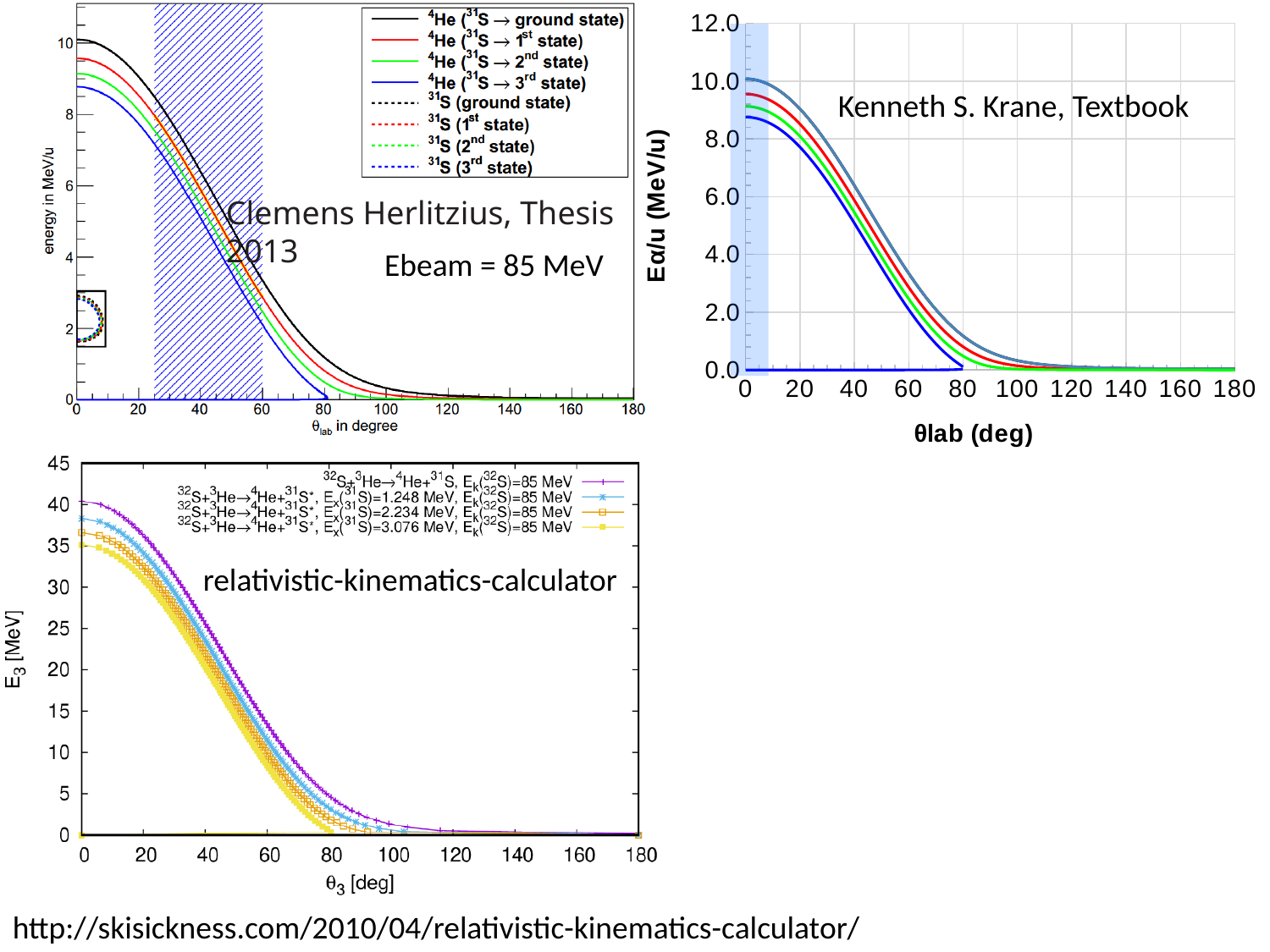
In the top-left chart (Clemens Herlitzius, Thesis 2013), do the 4He energy curves rise or fall as the lab angle increases? fall In the top-right chart (Kenneth S. Krane, Textbook), what is the label of the y axis? Eα/u (MeV/u) In the bottom-left chart (relativistic-kinematics-calculator), which series has the lowest E3 at 0 degrees? 32S+3He→4He+31S*, Ex(31S)=3.076 MeV, Ek(32S)=85 MeV In the top-left chart (Clemens Herlitzius, Thesis 2013), what beam energy is stated on the chart? Ebeam = 85 MeV In the bottom-left chart (relativistic-kinematics-calculator), is the E3 value of the Ex(31S)=3.076 MeV series at 0 degrees greater or less than 40 MeV? less In the top-left chart (Clemens Herlitzius, Thesis 2013), what kind of chart is shown? line chart In the top-left chart (Clemens Herlitzius, Thesis 2013), how many entries does the legend list? 8 In the bottom-left chart (relativistic-kinematics-calculator), which series has the highest E3 at 0 degrees? 32S+3He→4He+31S, Ek(32S)=85 MeV In the top-right chart (Kenneth S. Krane, Textbook), is the value of the lowest (blue) curve at 0 degrees greater or less than 10.0 MeV/u? less In the top-left chart (Clemens Herlitzius, Thesis 2013), is the energy of the 4He (31S → ground state) curve at 0 degrees greater or less than 8 MeV/u? greater In the bottom-left chart (relativistic-kinematics-calculator), how many series does the legend list? 4 In the top-right chart (Kenneth S. Krane, Textbook), do the curves rise or fall as θlab increases from 0 to 100 degrees? fall